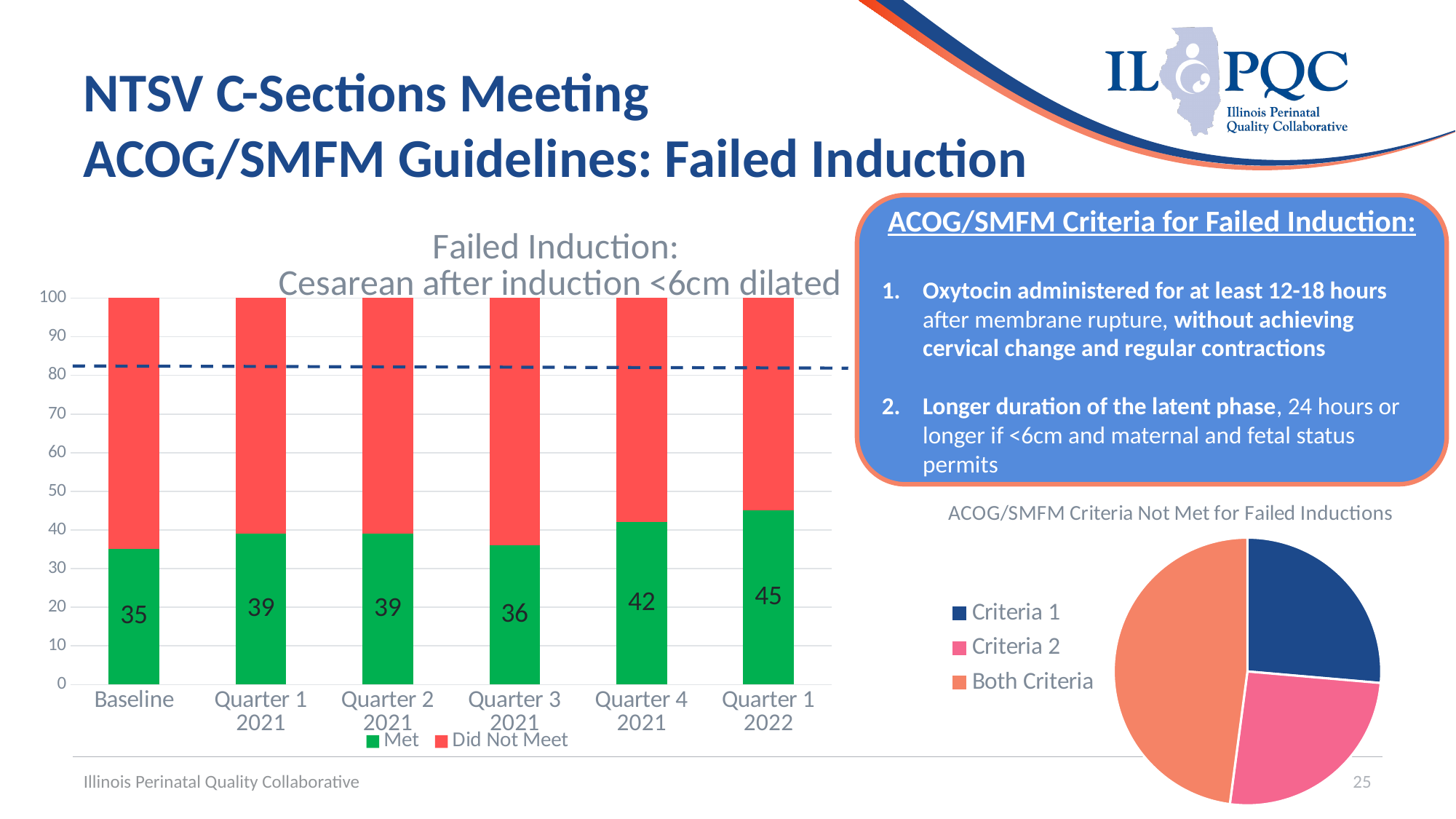
In the 'Failed Induction: Cesarean after induction <6cm dilated' bar chart, which has the larger Met value, Quarter 3 2021 or Quarter 4 2021? Quarter 4 2021 In the 'ACOG/SMFM Criteria Not Met for Failed Inductions' pie chart, which category has the largest slice? Both Criteria In the 'Failed Induction: Cesarean after induction <6cm dilated' bar chart, what is the Met value for Baseline? 35 In the 'Failed Induction: Cesarean after induction <6cm dilated' bar chart, which period has the highest Met value? Quarter 1 2022 How many series does the legend of the 'Failed Induction: Cesarean after induction <6cm dilated' bar chart list? 2 How many periods are shown on the x axis of the 'Failed Induction: Cesarean after induction <6cm dilated' bar chart? 6 How many categories does the legend of the 'ACOG/SMFM Criteria Not Met for Failed Inductions' pie chart list? 3 In the 'Failed Induction: Cesarean after induction <6cm dilated' bar chart, which period has the lowest Met value? Baseline In the 'Failed Induction: Cesarean after induction <6cm dilated' bar chart, is the Did Not Meet value for Baseline greater or less than 60? greater What kind of chart is 'Failed Induction: Cesarean after induction <6cm dilated'? Stacked bar chart In the 'Failed Induction: Cesarean after induction <6cm dilated' bar chart, how much higher is the Met value for Quarter 1 2022 than for Baseline? 10 In the 'Failed Induction: Cesarean after induction <6cm dilated' bar chart, what is the Met value for Quarter 1 2022? 45